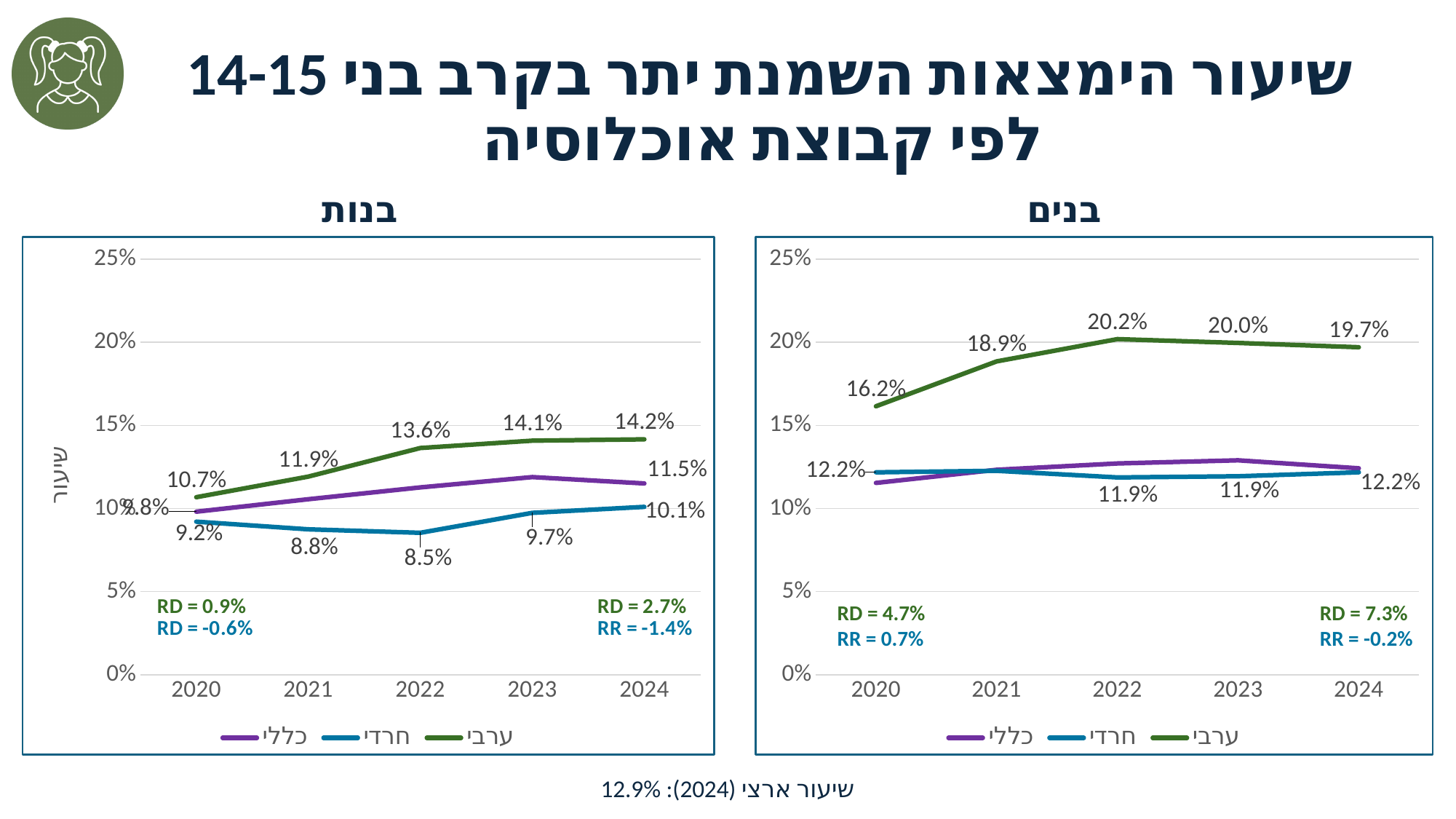
In the בנים chart, what is the value for ערבי in 2022? 20.2% In the בנות chart, what is the value for ערבי in 2024? 14.2% How many series does the legend of the בנים chart list? 3 What kind of charts are shown on the slide? line charts In the בנים chart, what is the value for ערבי in 2020? 16.2% In the בנות chart, what is the value for חרדי in 2022? 8.5% In the בנים chart, which is larger in 2021: the ערבי value or the חרדי value? ערבי In the בנות chart, is the value for כללי in 2022 greater or less than 15%? less In the בנות chart, what is the difference between the ערבי values in 2024 and 2020? 3.5% In the בנים chart, in which year is the ערבי value highest? 2022 In the בנות chart, does the ערבי line rise or fall from 2020 to 2024? rises In the בנות chart, in which year is the חרדי value lowest? 2022